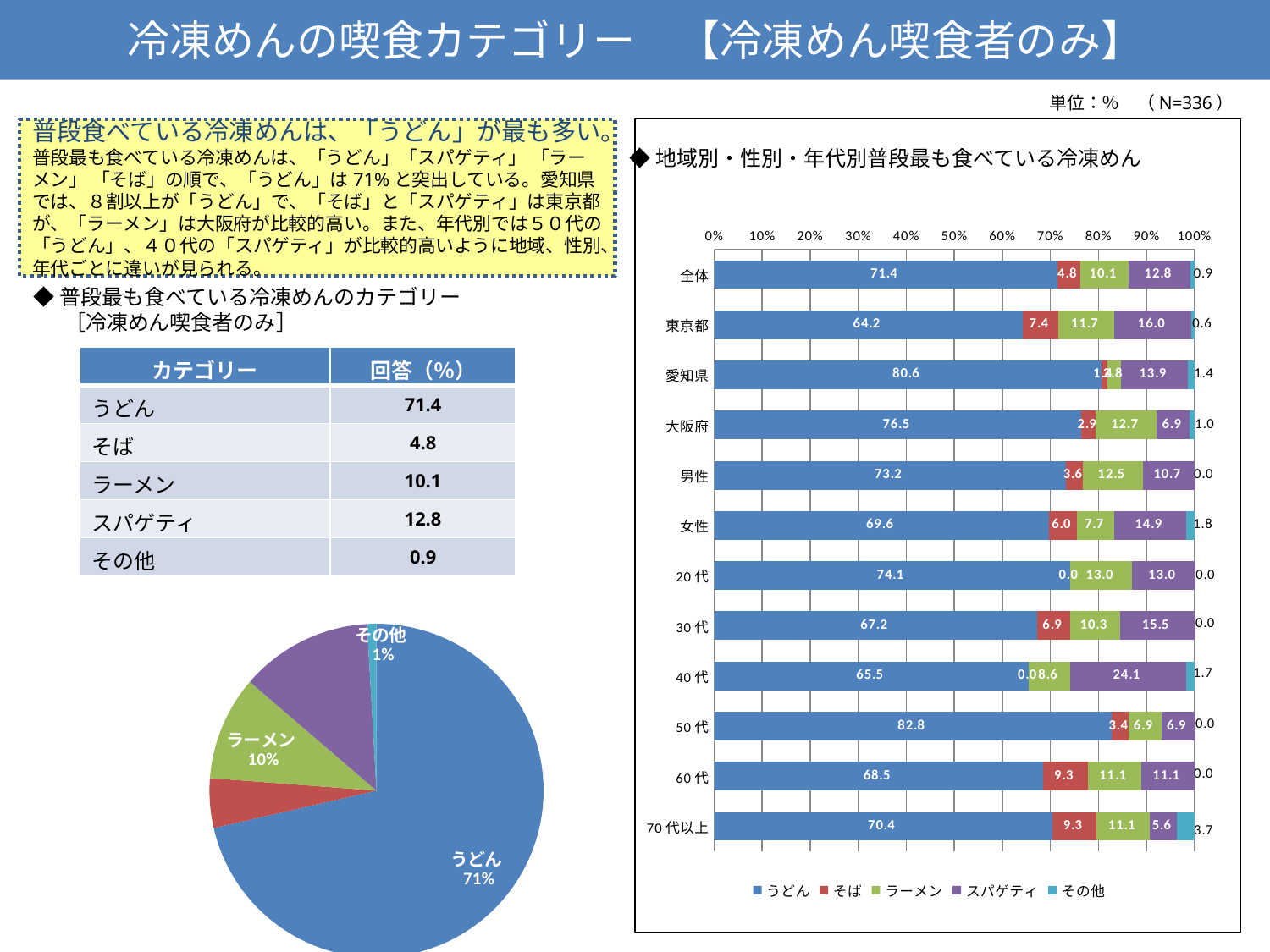
In the bar chart titled 地域別・性別・年代別普段最も食べている冷凍めん, what is the value for スパゲティ in the 40代 row? 24.1 What kind of chart is the chart on the right side of the slide? Stacked bar chart In the bar chart titled 地域別・性別・年代別普段最も食べている冷凍めん, which category has the lowest value for うどん? 東京都 In the bar chart titled 地域別・性別・年代別普段最も食べている冷凍めん, which is larger, the スパゲティ value for 女性 or for 男性? 女性 In the bar chart titled 地域別・性別・年代別普段最も食べている冷凍めん, how many series does the legend list? 5 In the pie chart at the bottom left of the slide, what share does うどん have? 71% In the bar chart titled 地域別・性別・年代別普段最も食べている冷凍めん, what is the difference between the うどん values for 50代 and 東京都? 18.6 In the pie chart at the bottom left of the slide, what share does ラーメン have? 10% In the bar chart titled 地域別・性別・年代別普段最も食べている冷凍めん, how many categories are shown on the vertical axis? 12 In the bar chart titled 地域別・性別・年代別普段最も食べている冷凍めん, what is the value for そば in the 東京都 row? 7.4 In the bar chart titled 地域別・性別・年代別普段最も食べている冷凍めん, what is the value for うどん in the 全体 row? 71.4 In the bar chart titled 地域別・性別・年代別普段最も食べている冷凍めん, which category has the highest value for うどん? 50代